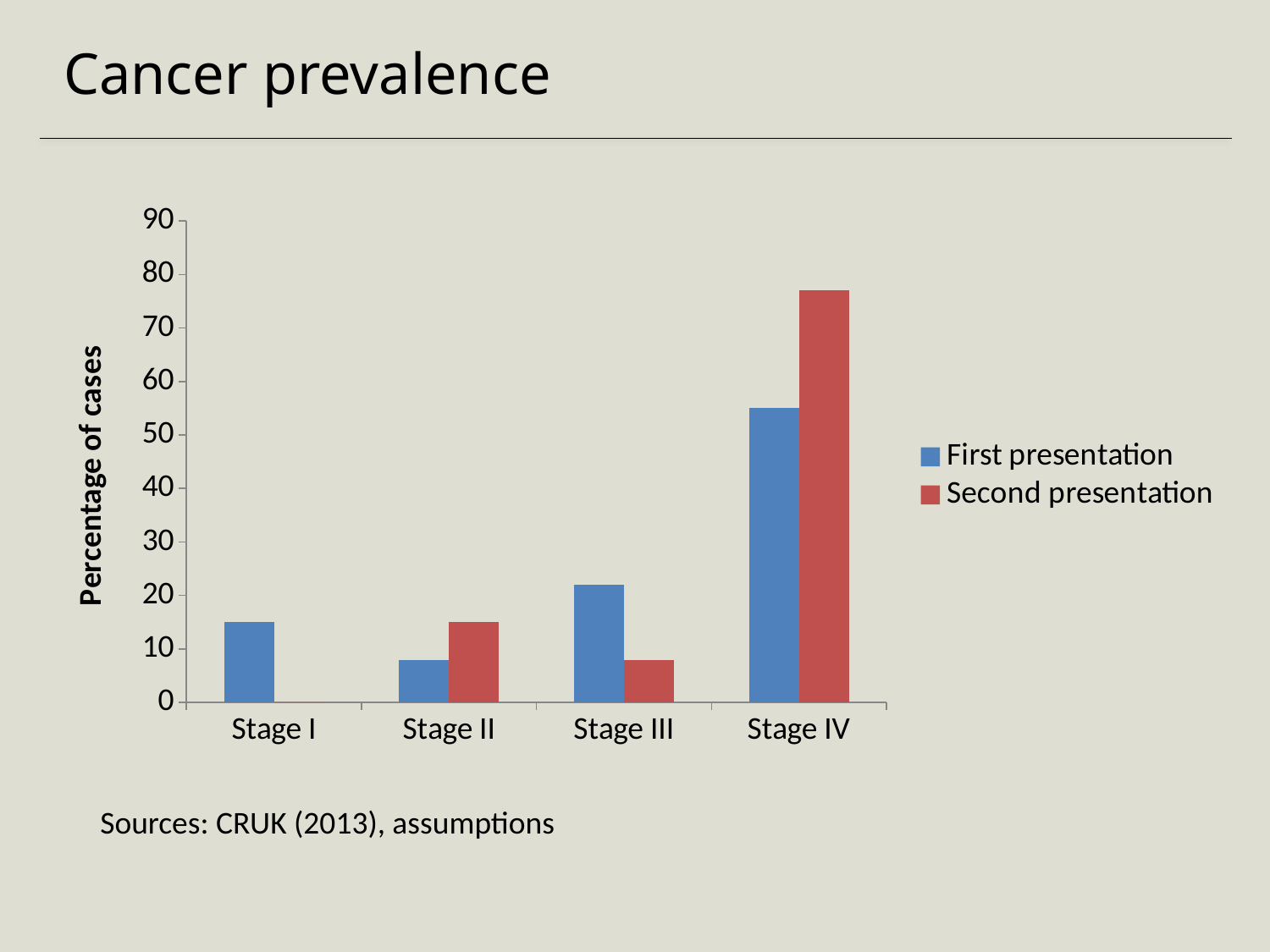
Is the value for First presentation at Stage IV greater or less than 60? less What kind of chart is shown on the slide? bar chart Is the value for Second presentation at Stage IV greater or less than 70? greater How many stage categories are shown on the x axis? 4 At Stage III, which is larger: First presentation or Second presentation? First presentation At Stage IV, which is larger: First presentation or Second presentation? Second presentation How many series does the legend list? 2 Which stage has the lowest value for First presentation? Stage II Which stage has the highest value for First presentation? Stage IV Which stage has the highest value for Second presentation? Stage IV What is the label of the vertical axis? Percentage of cases